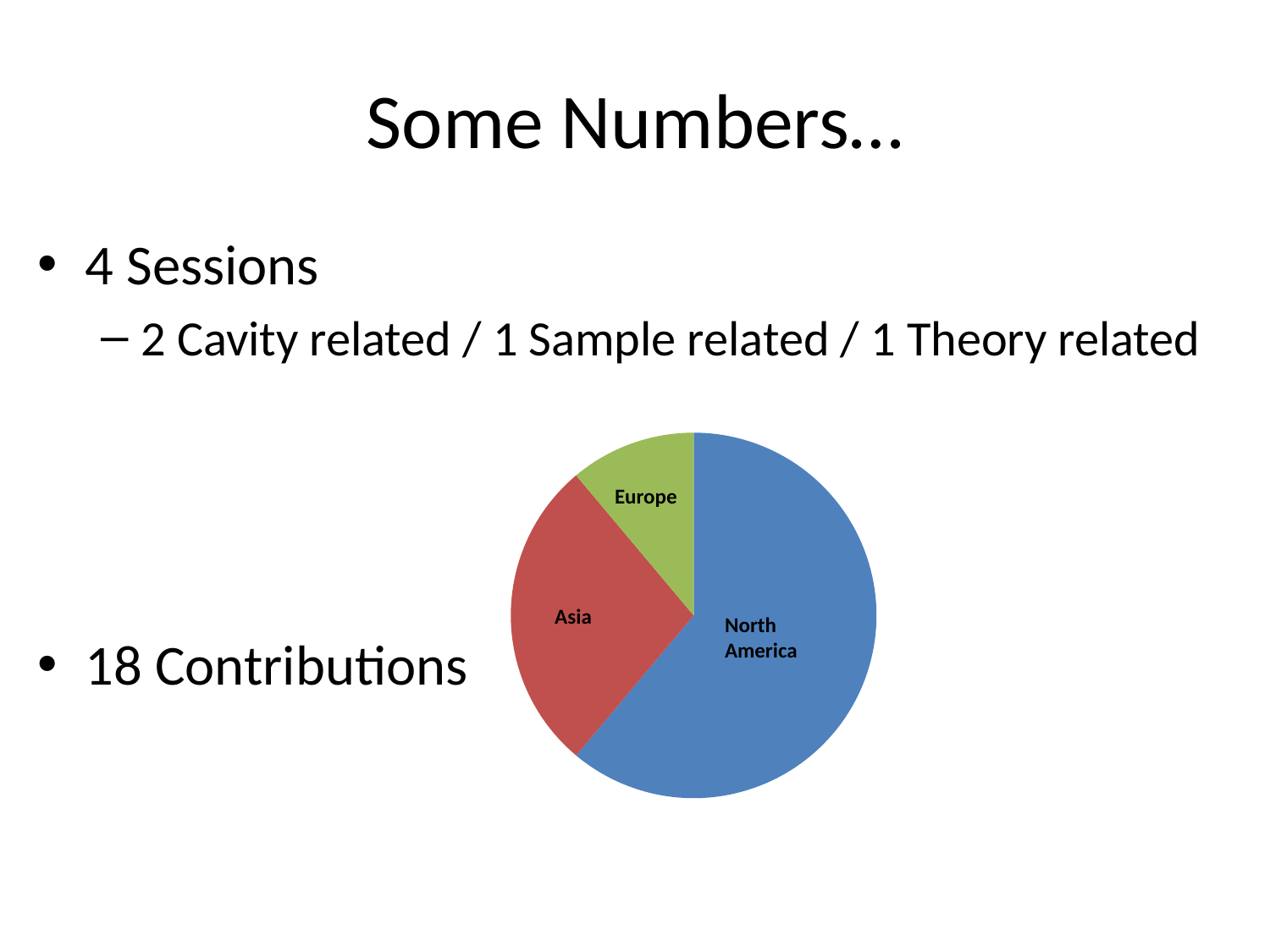
Which slice is larger in the pie chart, Asia or Europe? Asia Which slice is larger in the pie chart, North America or Asia? North America Which slice of the pie chart is the largest? North America Which slice of the pie chart is the smallest? Europe Which slice of the pie chart is coloured green? Europe How many slices does the pie chart have? 3 Which slice is larger in the pie chart, Europe or North America? North America What kind of chart is shown on the slide? pie chart What colour is the North America slice in the pie chart? blue